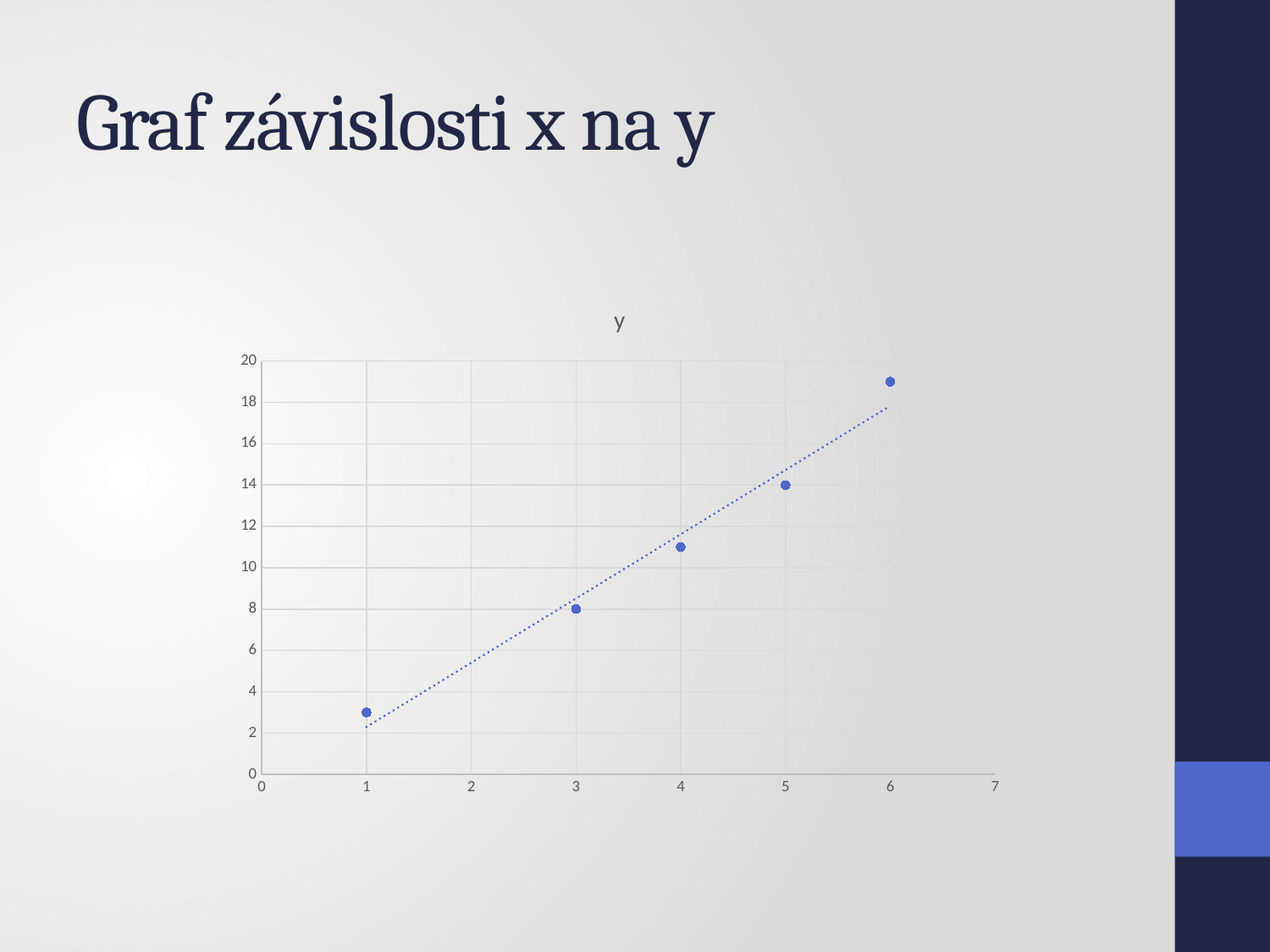
Is the y value of the point at x = 4 greater or less than 10? greater At which x value is the y value highest? 6 How many data points are plotted on the chart? 5 Do the y values rise or fall as x increases? rise What kind of chart is shown on the slide? scatter chart Is the y value of the point at x = 6 greater or less than 18? greater What is the y value of the point at x = 3? 8 What is the y value of the point at x = 5? 14 At which x value is the y value lowest? 1 Which point has the larger y value, the one at x = 3 or the one at x = 5? x = 5 Is the y value of the point at x = 1 greater or less than 4? less What is the title of the chart? y